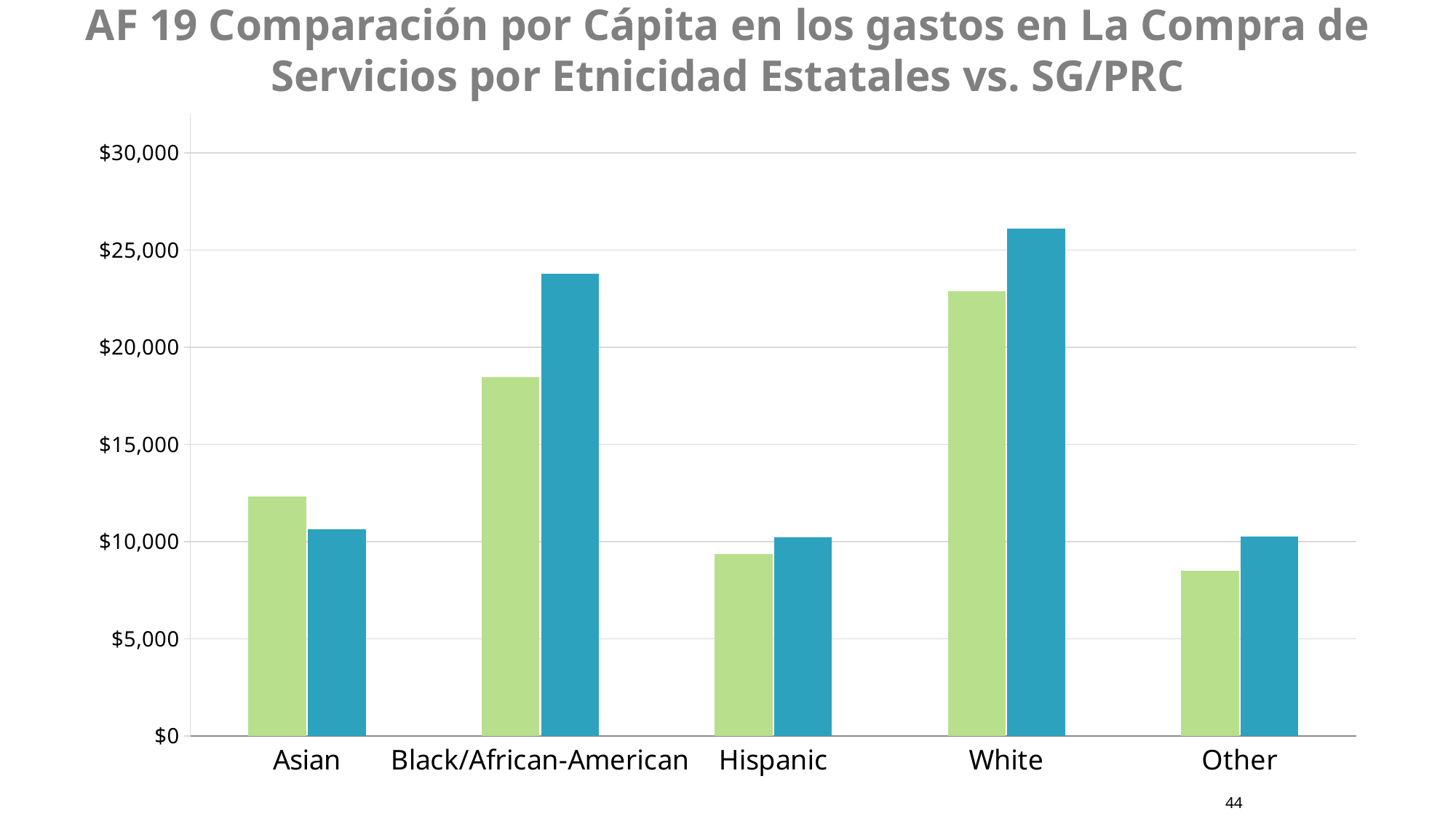
Which category has the shortest green bar? Other Is the blue bar for White greater or less than $25,000? greater For Black/African-American, which bar is taller, the green bar or the blue bar? blue Is the green bar for Other greater or less than $10,000? less How many ethnicity categories are shown on the x axis? 5 How many bars are shown for each ethnicity category? 2 What kind of chart is shown on the slide? bar chart For Asian, which bar is taller, the green bar or the blue bar? green Is the green bar for Black/African-American greater or less than $15,000? greater Which category has the tallest blue bar? White Which category has the tallest green bar? White